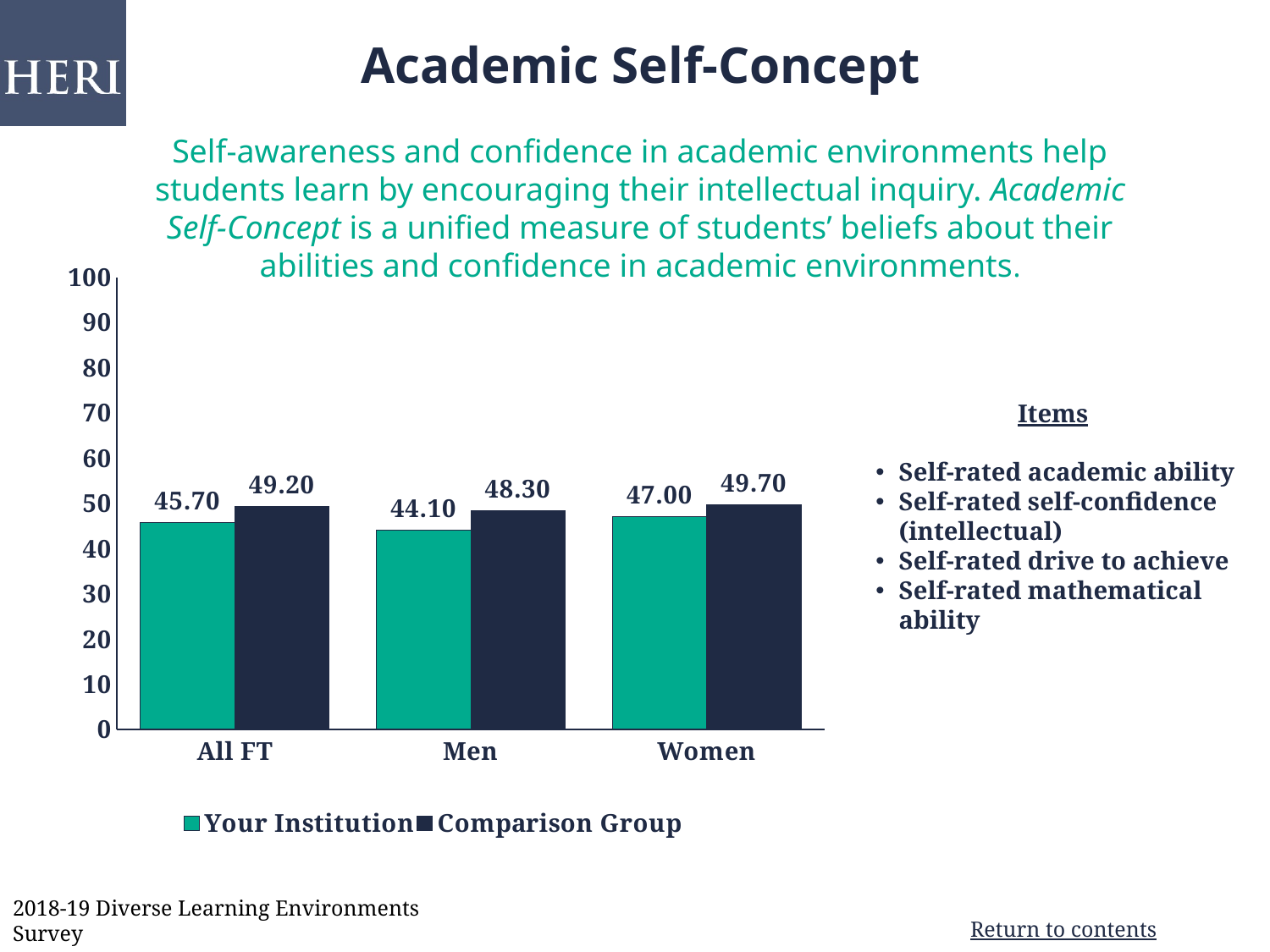
Is the value for Your Institution in the All FT category greater or less than 50? less How many series does the legend list? 2 Which is larger for Women: Your Institution or Comparison Group? Comparison Group What is the title of the slide containing the chart? Academic Self-Concept Which category has the highest value for Your Institution? Women What kind of chart is shown on the slide? bar chart Which category has the lowest value for Comparison Group? Men What is the value for Your Institution in the Men category? 44.10 How many categories are shown on the x axis? 3 What is the value for Your Institution in the All FT category? 45.70 What is the difference between the Comparison Group and Your Institution values for Men? 4.20 What is the value for Comparison Group in the Women category? 49.70